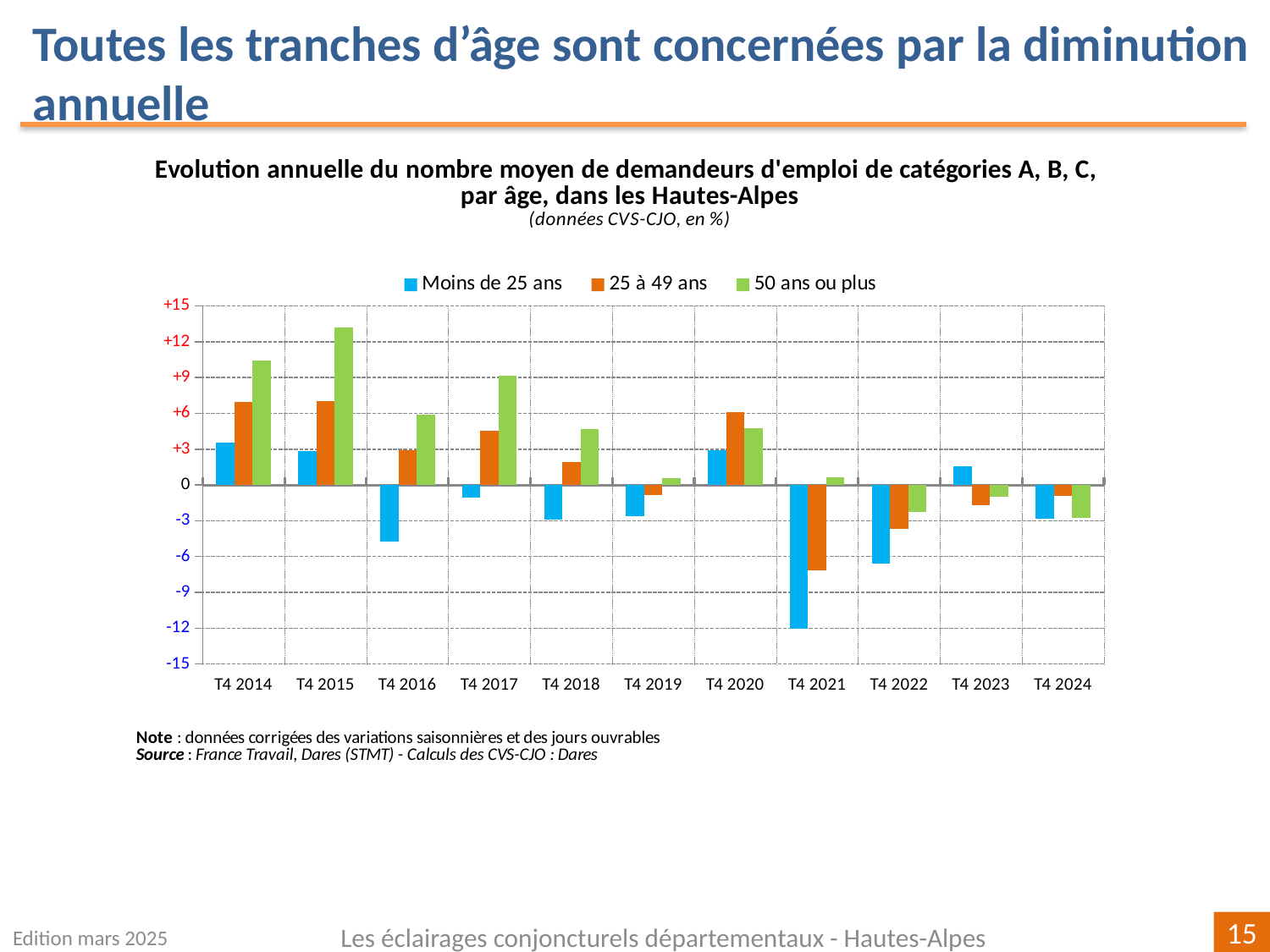
In T4 2014, which is larger: the value for Moins de 25 ans or for 25 à 49 ans? 25 à 49 ans In which quarter and for which age group is the lowest value on the chart? T4 2021, Moins de 25 ans In T4 2020, which is larger: the value for 25 à 49 ans or for 50 ans ou plus? 25 à 49 ans Is the value for 50 ans ou plus in T4 2017 greater or less than +6? greater Is the value for Moins de 25 ans in T4 2021 greater or less than -9? less What kind of chart is shown on the slide? bar chart Is the value for Moins de 25 ans in T4 2016 greater or less than -3? less Which colour represents the series Moins de 25 ans in the legend? blue How many series does the legend list? 3 In which quarter and for which age group is the highest value on the chart? T4 2015, 50 ans ou plus How many quarters (categories) are shown on the x axis? 11